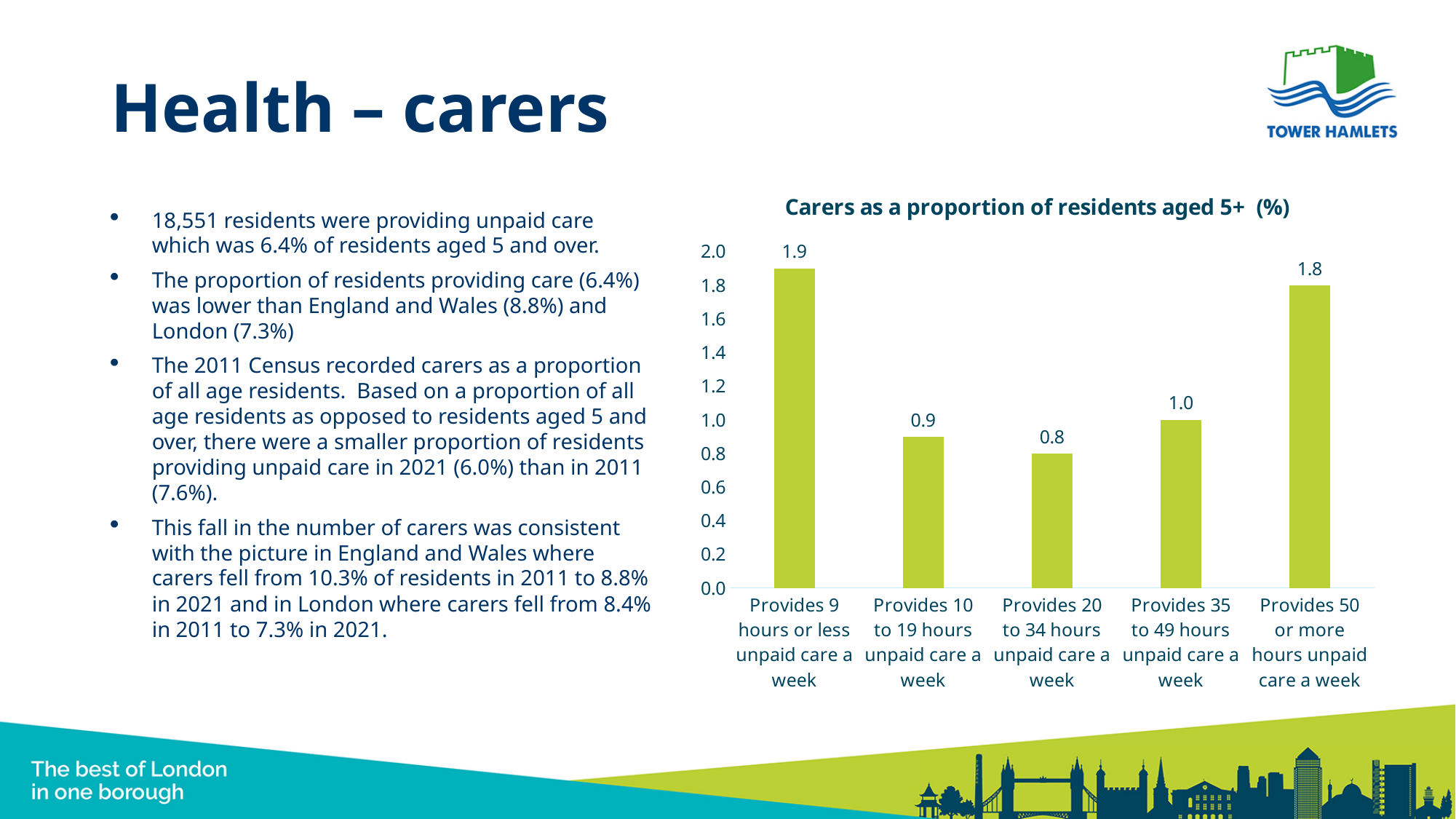
How many categories are shown in the chart? 5 What is the value for 'Provides 20 to 34 hours unpaid care a week'? 0.8 What is the value for 'Provides 9 hours or less unpaid care a week'? 1.9 What is the value for 'Provides 35 to 49 hours unpaid care a week'? 1.0 Is the value for 'Provides 50 or more hours unpaid care a week' greater or less than 1.0? greater What is the difference between the values for 'Provides 9 hours or less unpaid care a week' and 'Provides 10 to 19 hours unpaid care a week'? 1.0 What kind of chart is shown on the slide? Bar chart Which is larger: the value for 'Provides 35 to 49 hours unpaid care a week' or 'Provides 10 to 19 hours unpaid care a week'? Provides 35 to 49 hours unpaid care a week What is the value for 'Provides 50 or more hours unpaid care a week'? 1.8 Which category has the lowest value? Provides 20 to 34 hours unpaid care a week Which category has the highest value? Provides 9 hours or less unpaid care a week What is the title of the chart? Carers as a proportion of residents aged 5+ (%)